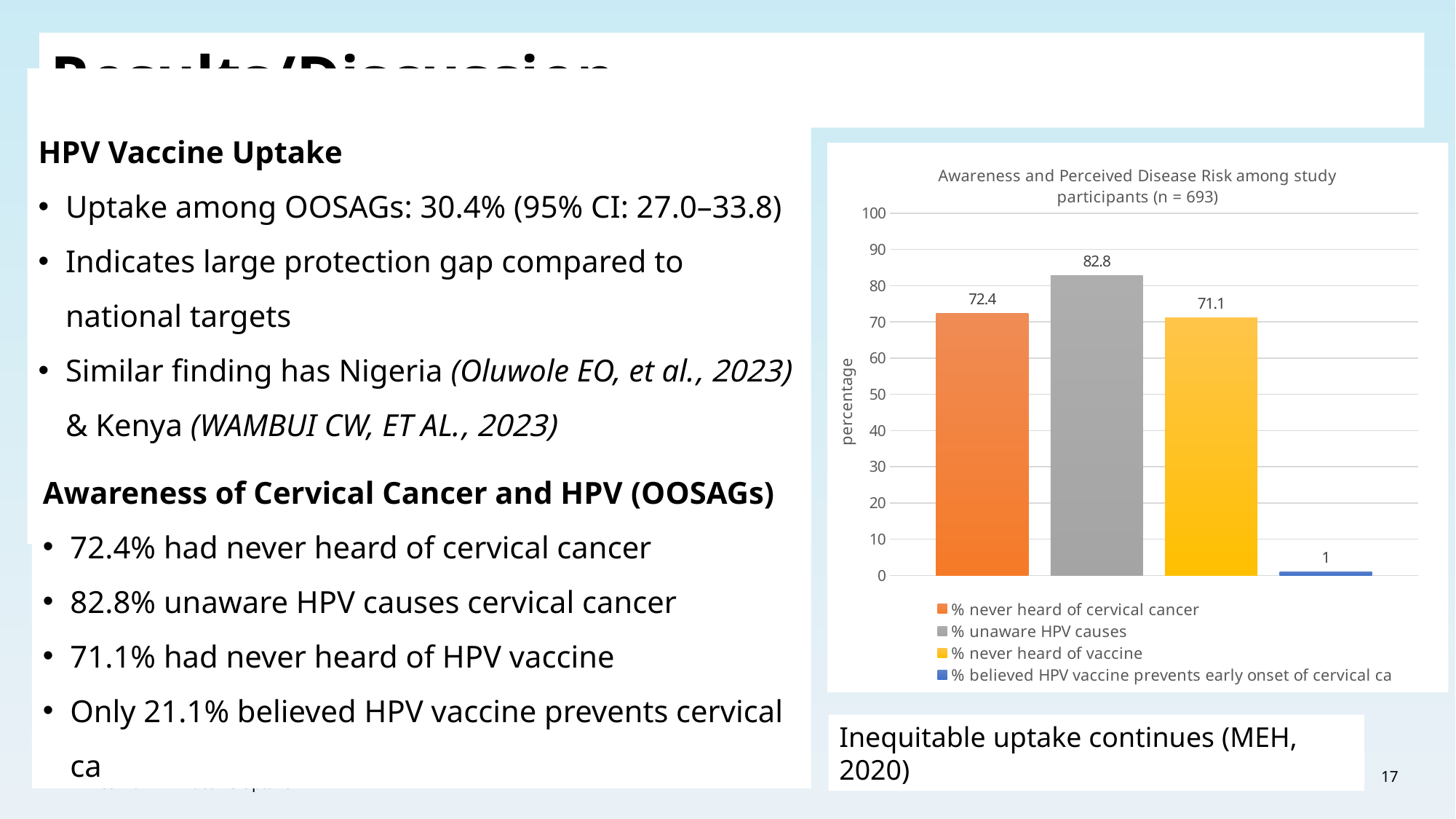
What is the value of the bar for "% never heard of vaccine"? 71.1 Which legend category has the highest bar? % unaware HPV causes What is the value of the bar for "% never heard of cervical cancer"? 72.4 Which is larger: the bar for "% never heard of cervical cancer" or the bar for "% never heard of vaccine"? % never heard of cervical cancer What is the value of the bar for "% unaware HPV causes"? 82.8 Which legend category has the lowest bar? % believed HPV vaccine prevents early onset of cervical ca What is the difference between the "% unaware HPV causes" bar and the "% never heard of cervical cancer" bar? 10.4 What type of chart is shown on the slide? Bar chart How many bars are plotted in the chart? 4 Is the value for "% unaware HPV causes" greater or less than 80? greater What is the label of the vertical axis of the chart? percentage What value is printed above the blue bar for "% believed HPV vaccine prevents early onset of cervical ca"? 1